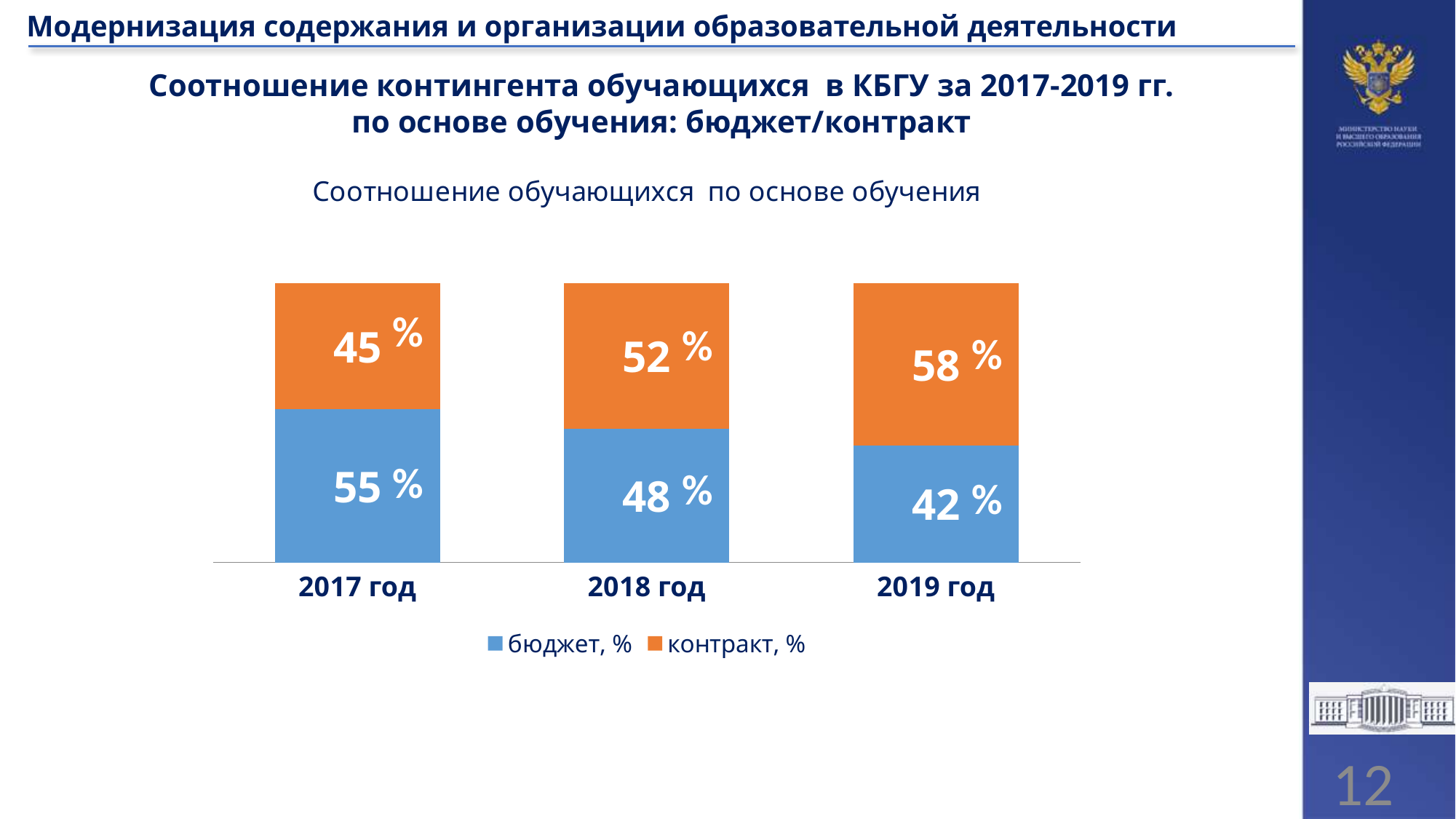
What is the value for контракт, % in 2018 год? 52 % What is the value for бюджет, % in 2017 год? 55 % In which year is the бюджет, % value highest? 2017 год What is the value for контракт, % in 2019 год? 58 % How many series does the legend list? 2 Does the бюджет, % value rise or fall from 2017 год to 2019 год? Fall What kind of chart is shown? Stacked bar chart How many years are shown on the x axis? 3 Which is larger in 2019 год: бюджет, % or контракт, %? контракт, % In which year is the контракт, % value lowest? 2017 год What is the value for бюджет, % in 2018 год? 48 % What is the difference between the контракт, % values for 2019 год and 2017 год? 13 %